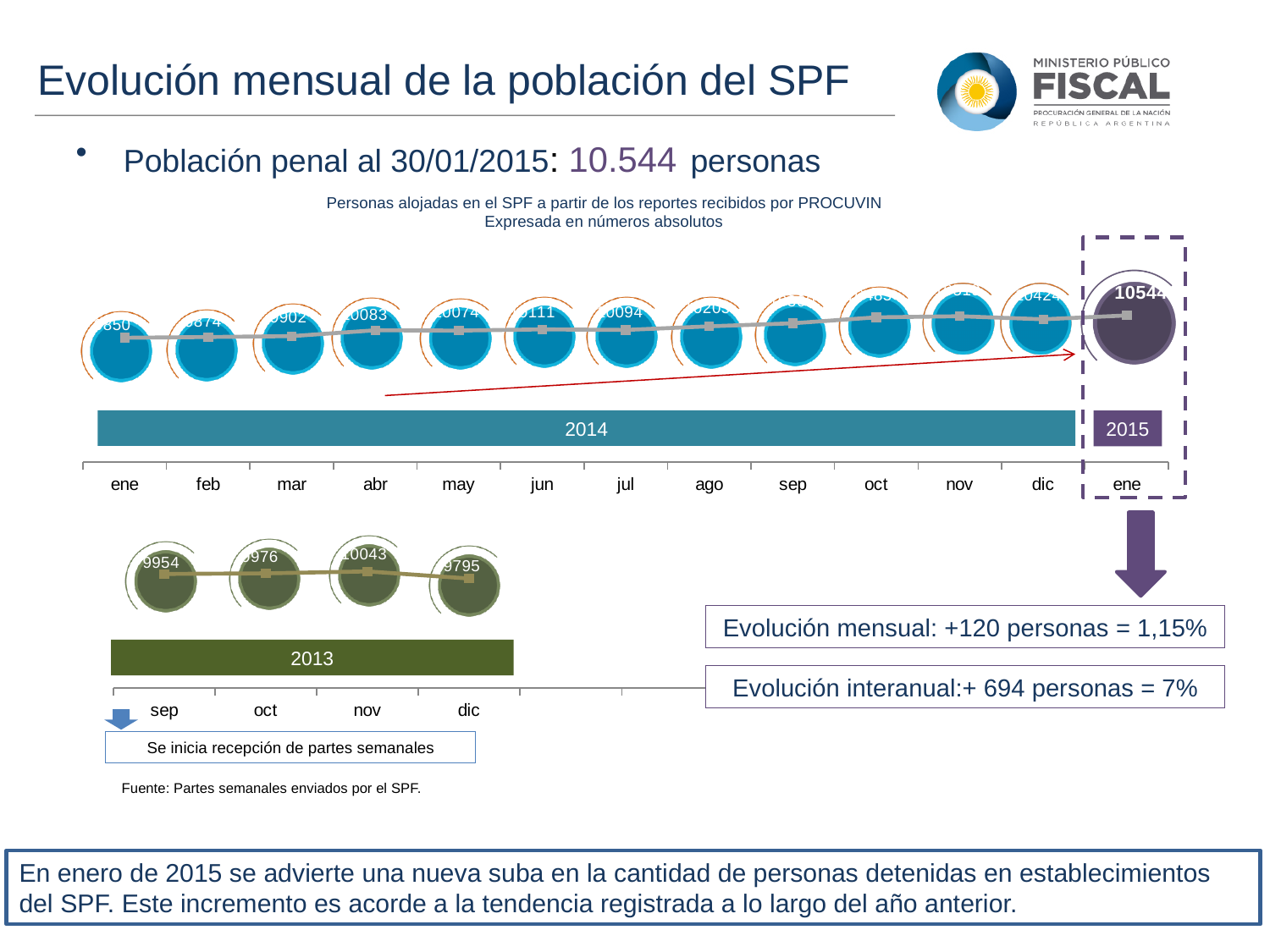
In the bottom chart (2013), what is the value for nov? 10043 In the top chart, what is the value for ene 2015? 10544 In the bottom chart (2013), which month has the lowest value? dic In the top chart, what is the difference between the values for ene 2015 and dic 2014? 120 What kind of chart is the top chart? line chart In the top chart, which is larger, the value for jun or the value for jul? jun In the bottom chart (2013), which month has the highest value? nov In the bottom chart (2013), what is the difference between the values for nov and dic? 248 In the top chart, do the values generally rise or fall from ene 2014 to ene 2015? rise In the bottom chart (2013), what is the value for dic? 9795 In the top chart, what is the value for dic 2014? 10424 In the bottom chart (2013), how many months are plotted? 4